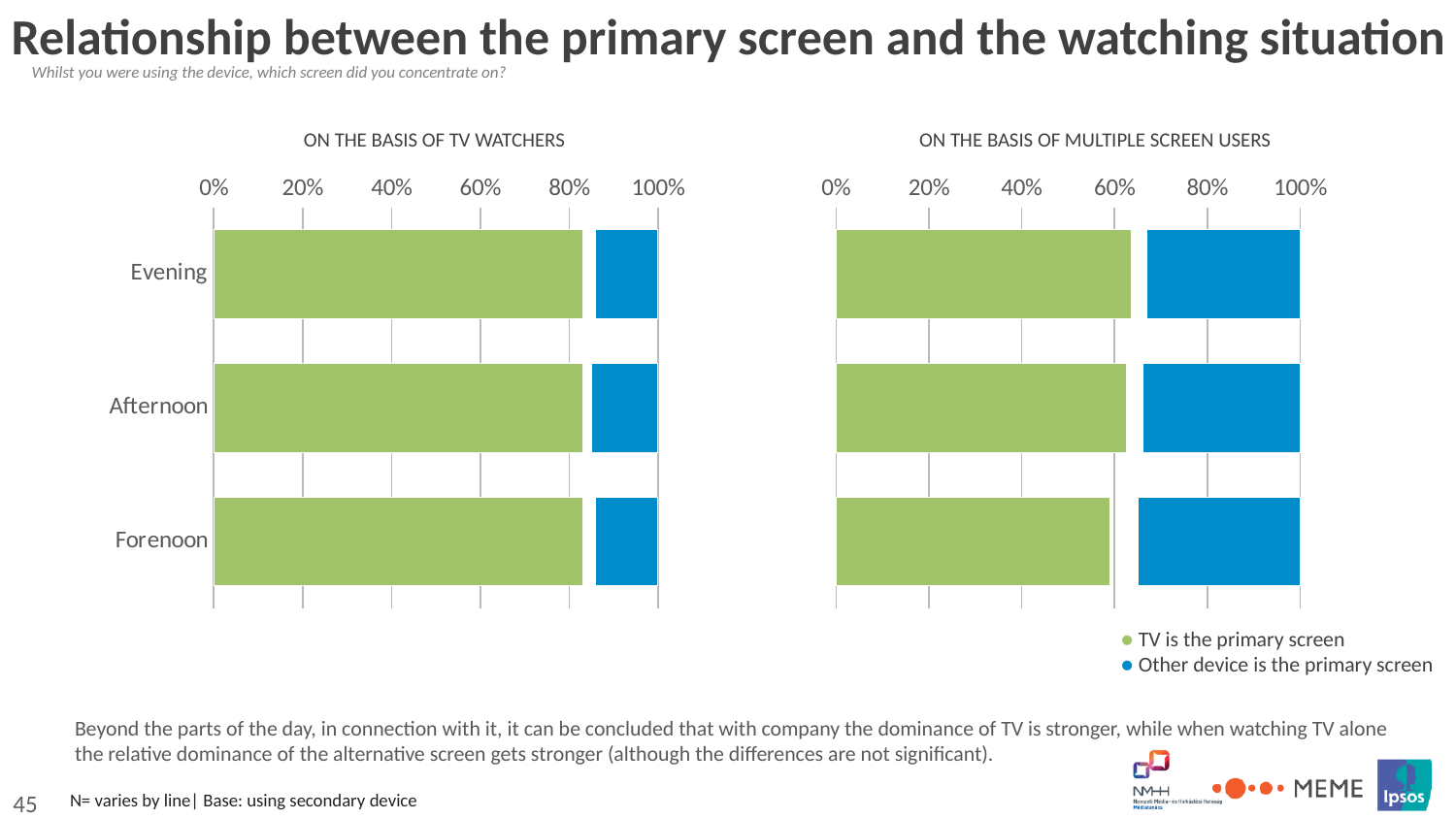
On the 'ON THE BASIS OF MULTIPLE SCREEN USERS' chart, is the value for 'TV is the primary screen' in the Evening greater or less than 80%? less On the 'ON THE BASIS OF TV WATCHERS' chart, is the value for 'TV is the primary screen' in the Evening greater or less than 80%? greater Which is larger for the Evening: 'TV is the primary screen' on the 'ON THE BASIS OF TV WATCHERS' chart or on the 'ON THE BASIS OF MULTIPLE SCREEN USERS' chart? ON THE BASIS OF TV WATCHERS On the 'ON THE BASIS OF MULTIPLE SCREEN USERS' chart, is the value for 'TV is the primary screen' in the Forenoon greater or less than 40%? greater On the 'ON THE BASIS OF MULTIPLE SCREEN USERS' chart, which is larger for the Afternoon: 'TV is the primary screen' or 'Other device is the primary screen'? TV is the primary screen How many categories are shown on the 'ON THE BASIS OF TV WATCHERS' chart? 3 What is the title of the chart on the right side of the slide? ON THE BASIS OF MULTIPLE SCREEN USERS How many series does the legend list? 2 What kind of chart is used on this slide? bar chart Which colour represents 'Other device is the primary screen' in the charts? blue